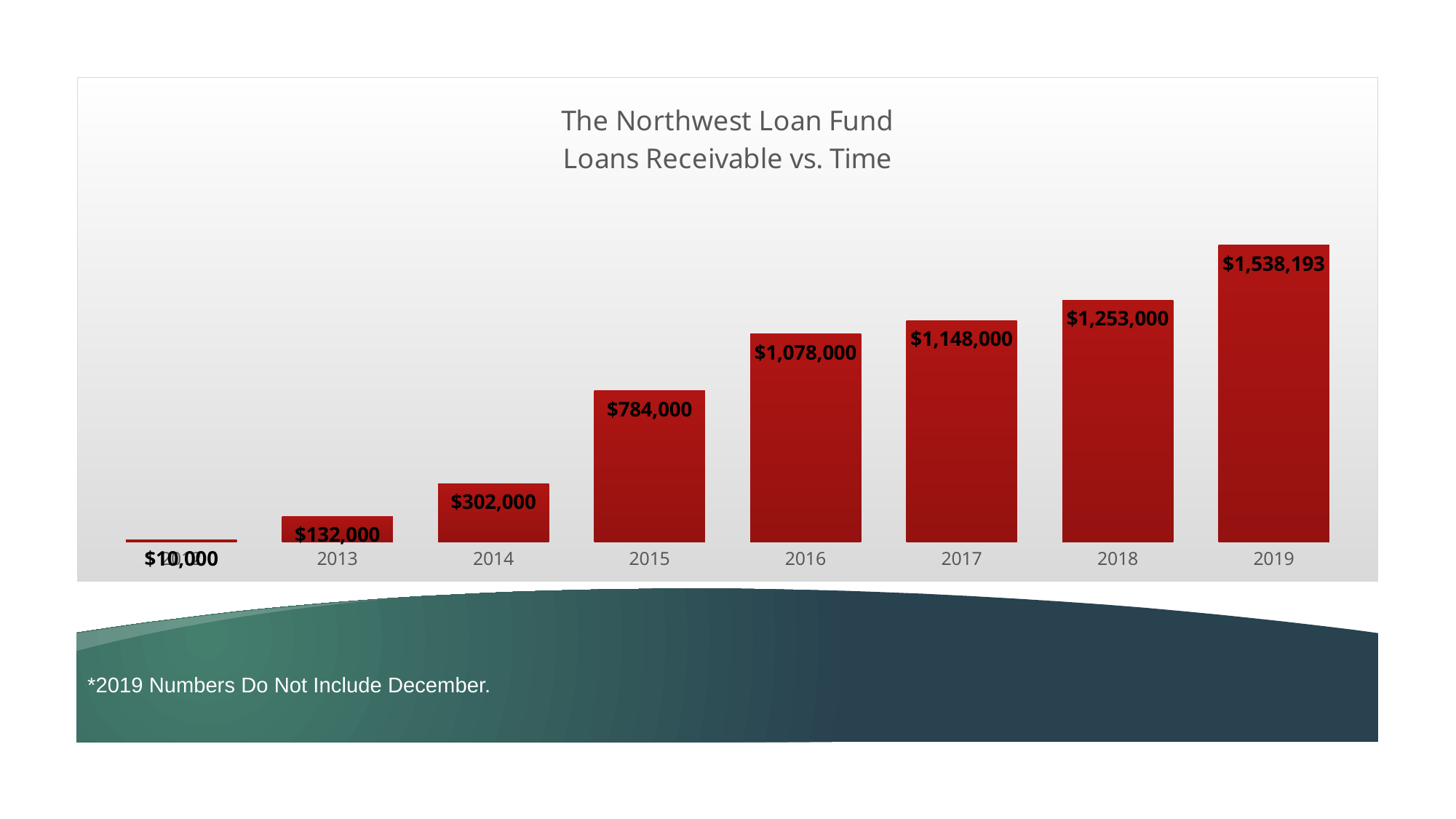
What kind of chart is shown on the slide? Bar chart How many bars are plotted in the chart? 8 What is the value for 2017? $1,148,000 What is the value for 2013? $132,000 What is the difference between the values for 2016 and 2015? $294,000 What is the value for 2015? $784,000 Which is larger, the value for 2014 or the value for 2013? 2014 Which year has the highest loans receivable? 2019 Do the values rise or fall from 2013 to 2019? Rise What is the value for 2019? $1,538,193 What is the title of the chart? The Northwest Loan Fund Loans Receivable vs. Time What is the difference between the values for 2018 and 2017? $105,000